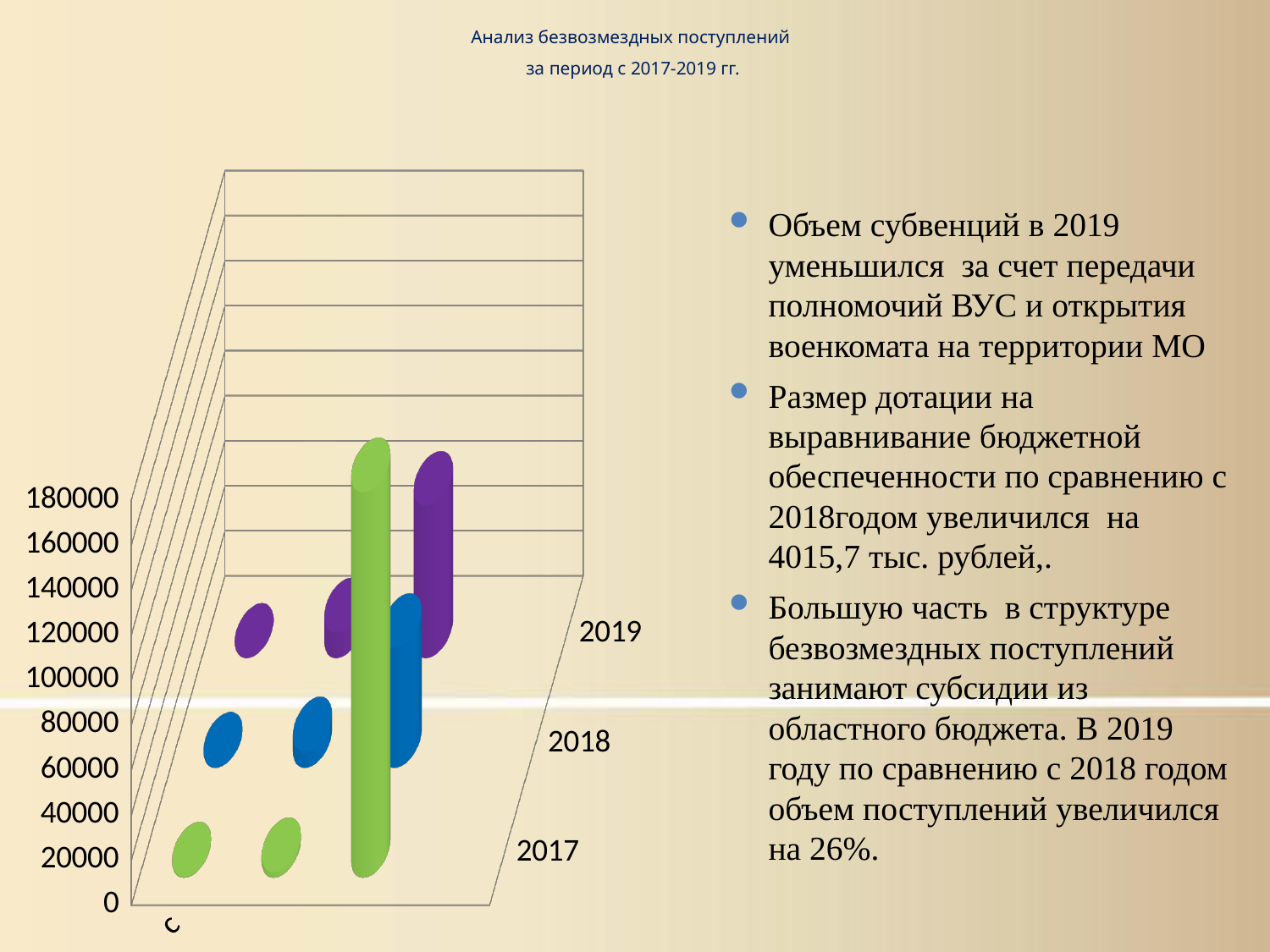
What kind of chart is shown on the slide? bar chart Which year has the tallest bar in the chart? 2017 Is the value of the tallest bar in the chart greater or less than 100000? greater Are the values of the two short green bars for 2017 greater or less than 40000? less Is the value of the tallest bar in the chart greater or less than 140000? greater Which years are shown along the depth axis of the chart? 2017, 2018, 2019 What is the highest value shown on the vertical axis of the chart? 180000 Which year's bars are shown in green? 2017 How many years are plotted in the chart? 3